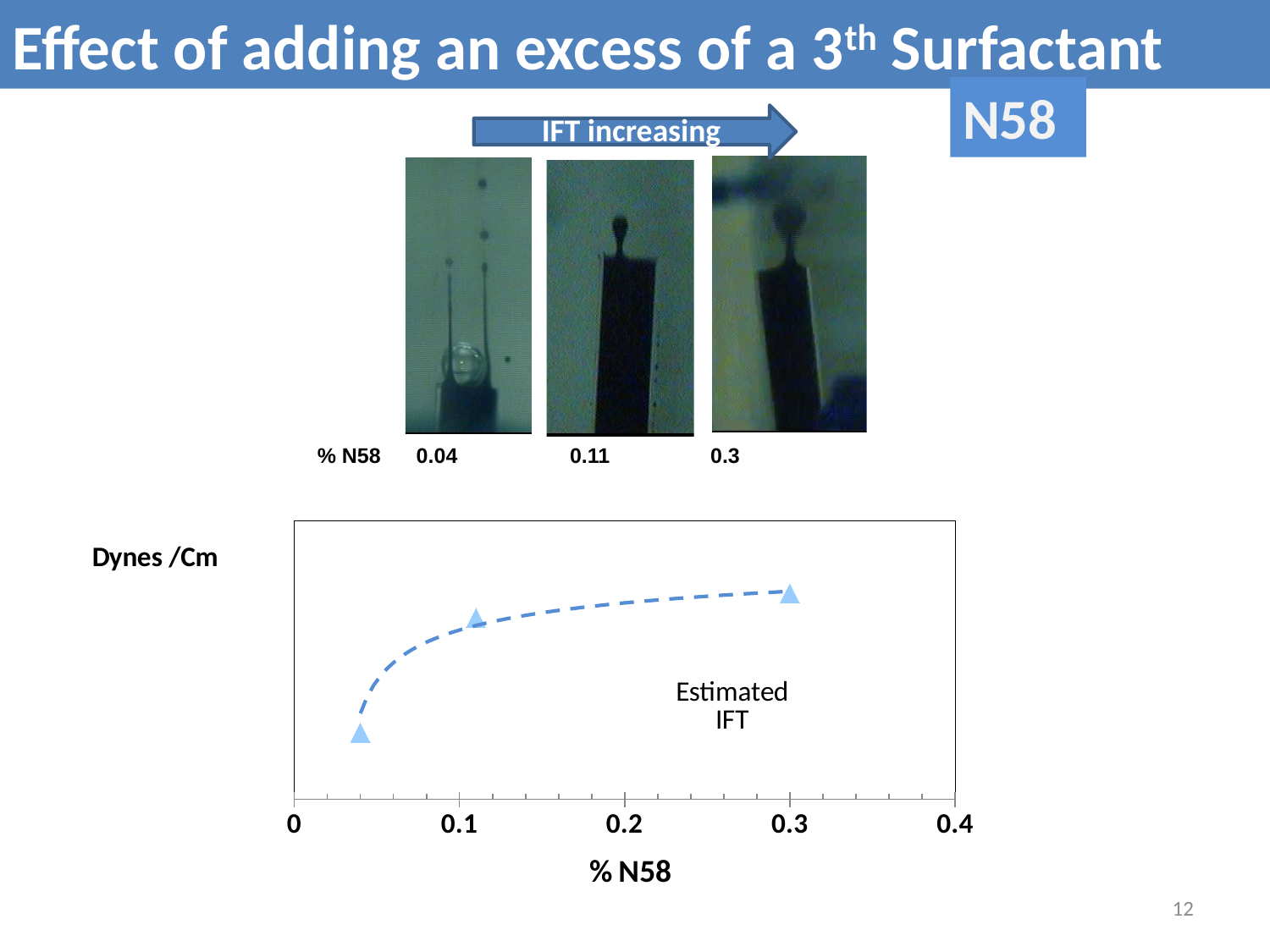
What is the % N58 value of the rightmost plotted point? 0.3 What unit is given for the y axis of the chart? Dynes /Cm What is the label of the x axis of the chart? % N58 Does the estimated IFT rise or fall as % N58 increases along the x axis? Rises Is the % N58 value of the leftmost plotted point greater or less than 0.1? less At which % N58 value is the plotted estimated IFT highest? 0.3 What is the highest value shown on the x axis of the chart? 0.4 What kind of chart is shown on the slide? Scatter chart with a dashed trend line Which has the larger estimated IFT: the point at 0.04 % N58 or the point at 0.3 % N58? 0.3 % N58 At which % N58 value is the plotted estimated IFT lowest? 0.04 Which has the larger estimated IFT: the point at 0.04 % N58 or the point at 0.11 % N58? 0.11 % N58 How many data points are plotted on the chart? 3